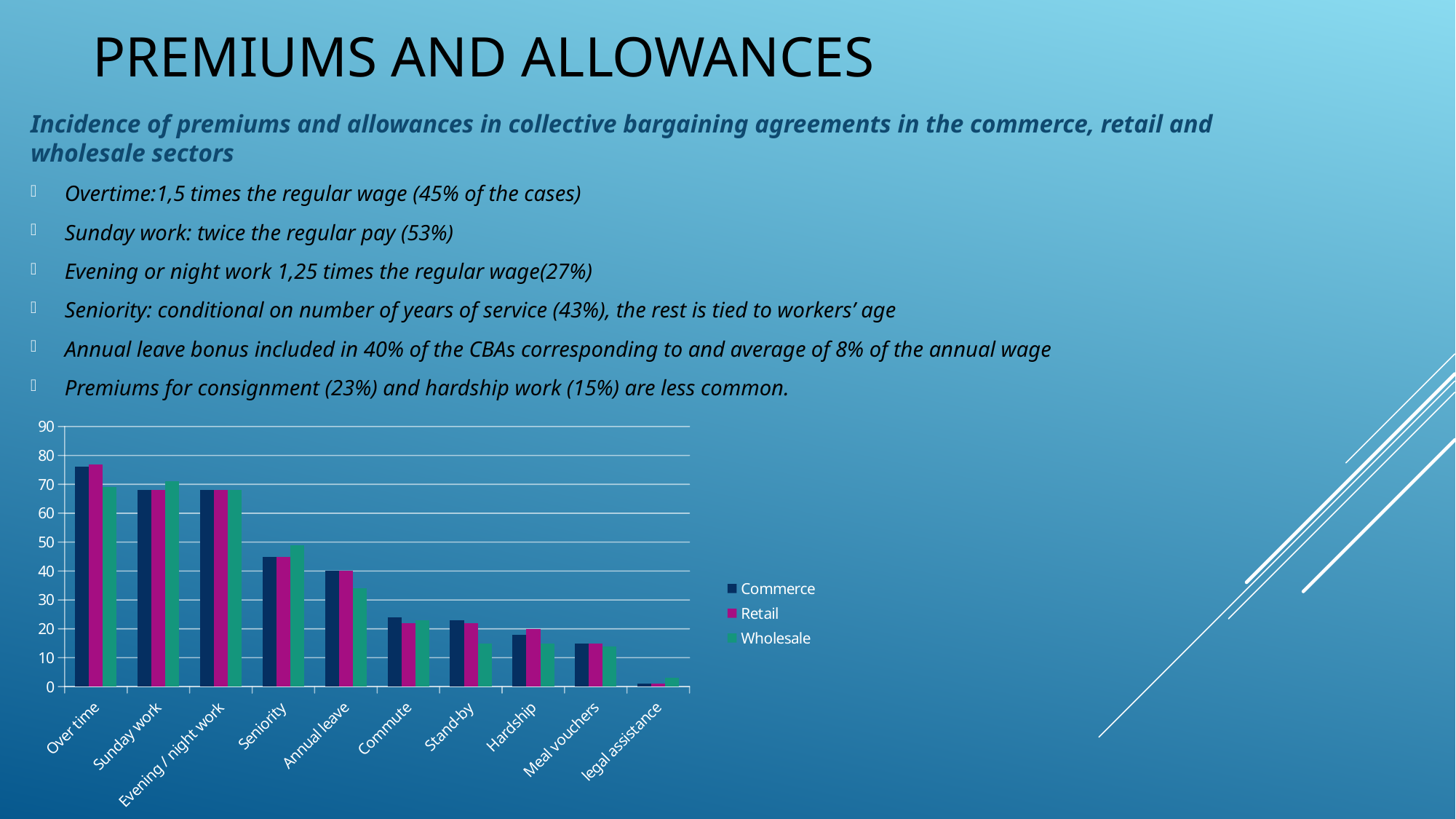
Do the Commerce values generally rise or fall moving from left to right along the x axis? fall How many series does the chart's legend list? 3 Is the Commerce value for Over time greater or less than 70? greater Which category has the highest Commerce value? Over time Is the Wholesale value for Annual leave greater or less than 40? less Which category has the lowest Retail value? legal assistance Is the Wholesale value for Stand-by greater or less than 20? less How many categories are shown along the x axis of the chart? 10 What kind of chart is shown on the slide? bar chart What are the three series named in the chart's legend? Commerce, Retail, Wholesale Which is larger for Wholesale: Seniority or Annual leave? Seniority